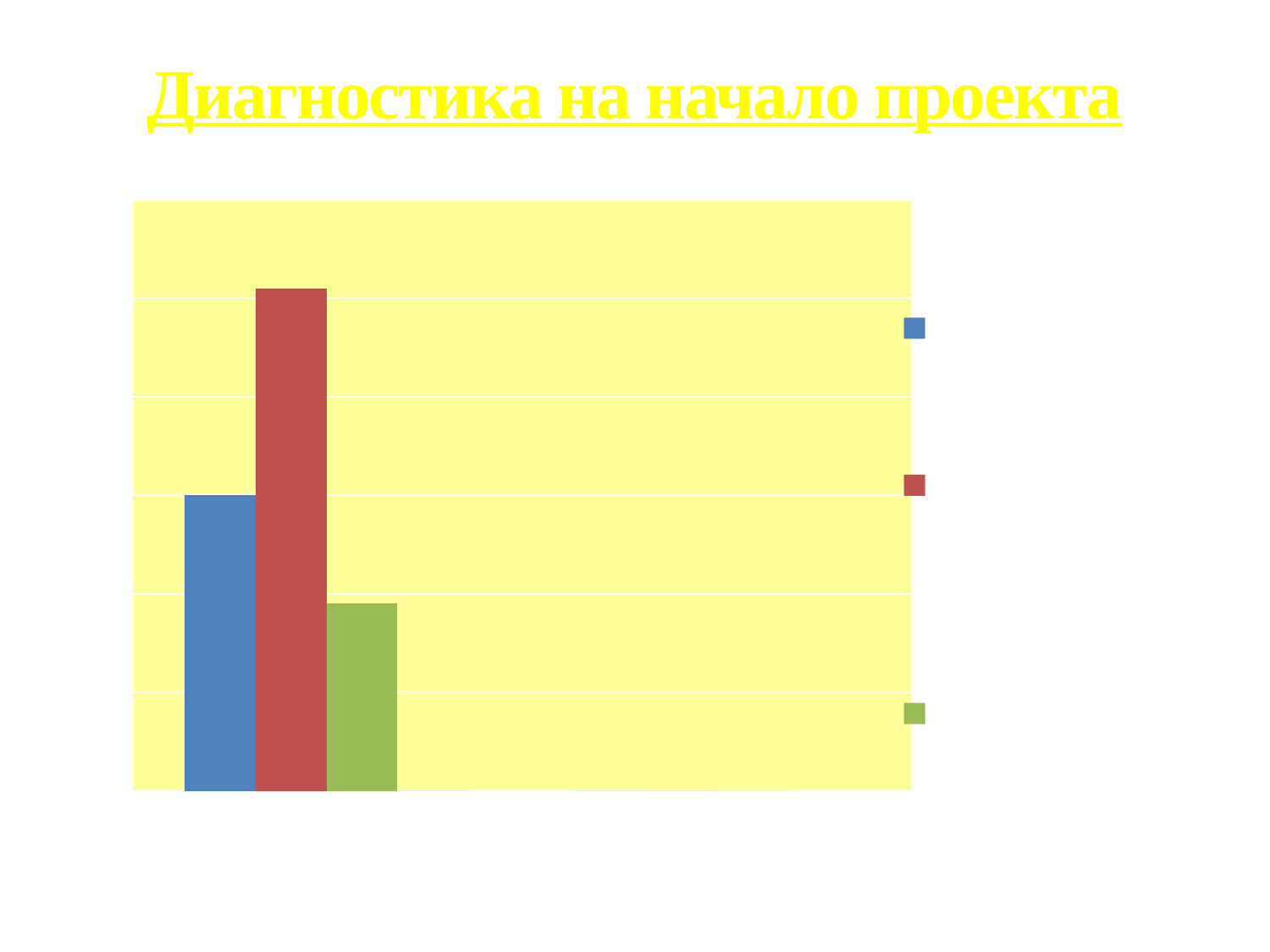
Which is taller, the red bar or the blue bar? the red bar How many entries does the legend show? 3 Which is taller, the blue bar or the green bar? the blue bar Which bar is the shortest in the chart? the green bar How many bars are plotted in the chart? 3 Which bar is the tallest in the chart? the red bar What is the title of the slide above the chart? Диагностика на начало проекта What kind of chart is shown on the slide? bar chart What colours are the three bars, from left to right? blue, red, green